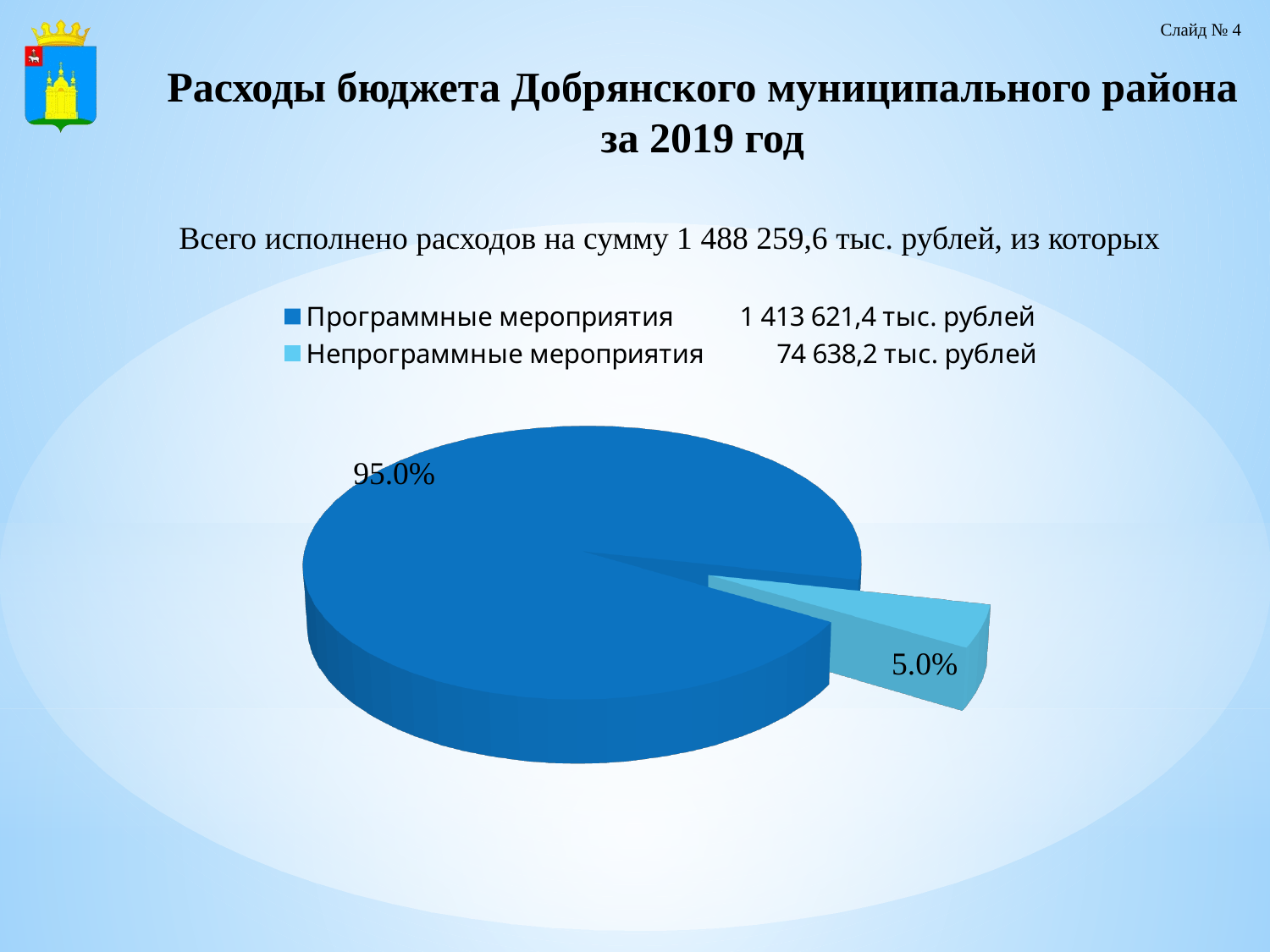
What is the value for Программные мероприятия in the legend? 1 413 621,4 тыс. рублей How many entries does the legend list? 2 How many slices does the pie chart have? 2 What is the value for Непрограммные мероприятия in the legend? 74 638,2 тыс. рублей Which category has the largest slice of the pie? Программные мероприятия What total amount of expenditures is stated on the slide? 1 488 259,6 тыс. рублей What share of the pie does Непрограммные мероприятия take? 5.0% Which category has the smallest slice of the pie? Непрограммные мероприятия Which is larger, Программные мероприятия or Непрограммные мероприятия? Программные мероприятия What is the difference in percentage points between the two slices of the pie? 90.0% What kind of chart is shown on the slide? pie chart What share of the pie does Программные мероприятия take? 95.0%